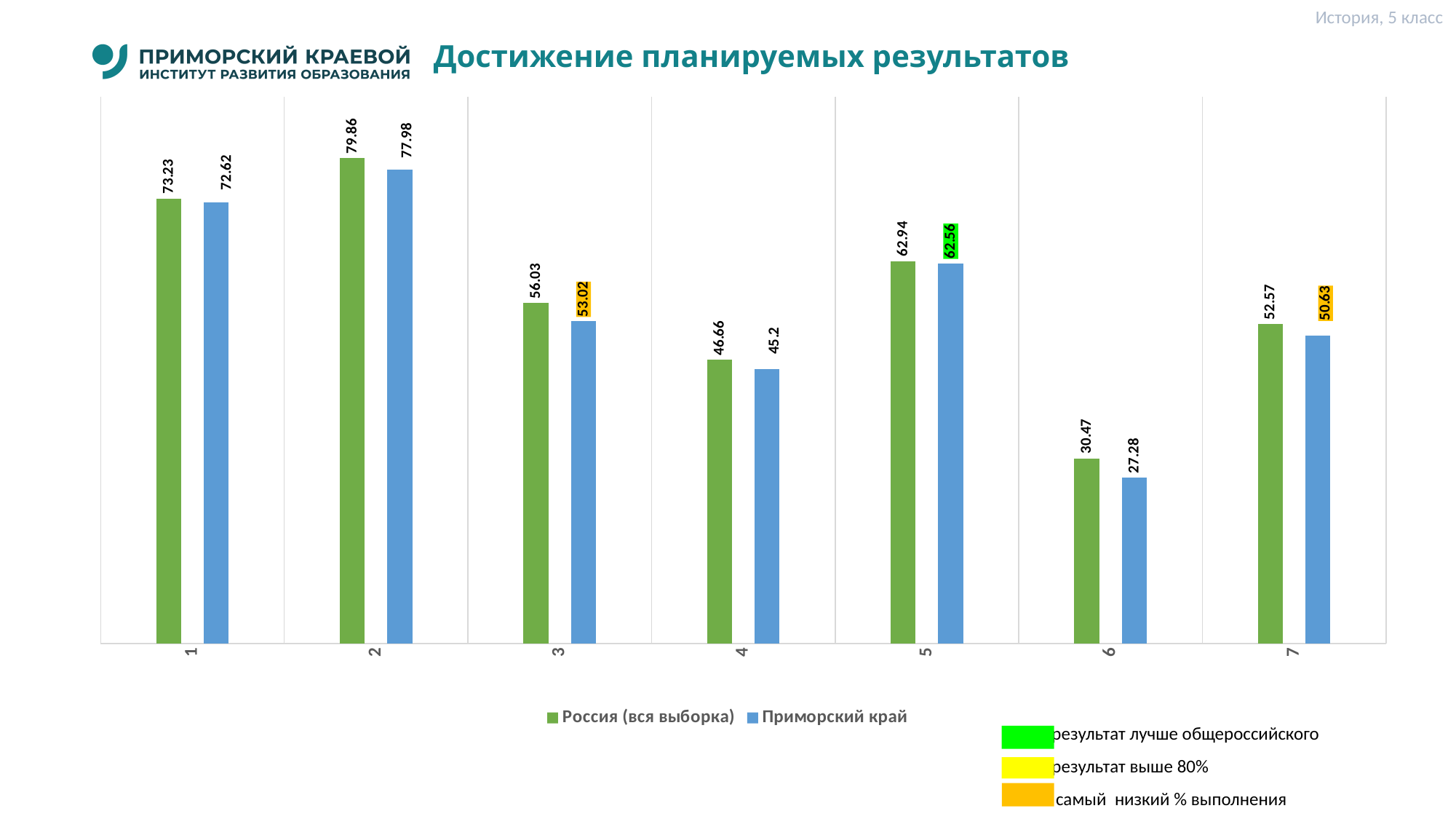
What kind of chart is shown on the slide? Bar chart What is the value for Россия (вся выборка) in category 6? 30.47 Which colour represents Приморский край in the chart? Blue What is the title of the chart? Достижение планируемых результатов Which category has the lowest value for Приморский край? 6 How many categories are shown on the x axis? 7 How many series does the legend list? 2 What is the value for Приморский край in category 2? 77.98 In category 6, which series has the larger value: Россия (вся выборка) or Приморский край? Россия (вся выборка) What is the value for Приморский край in category 5? 62.56 What is the difference between the Россия (вся выборка) and Приморский край values in category 3? 3.01 Which category has the highest value for Россия (вся выборка)? 2